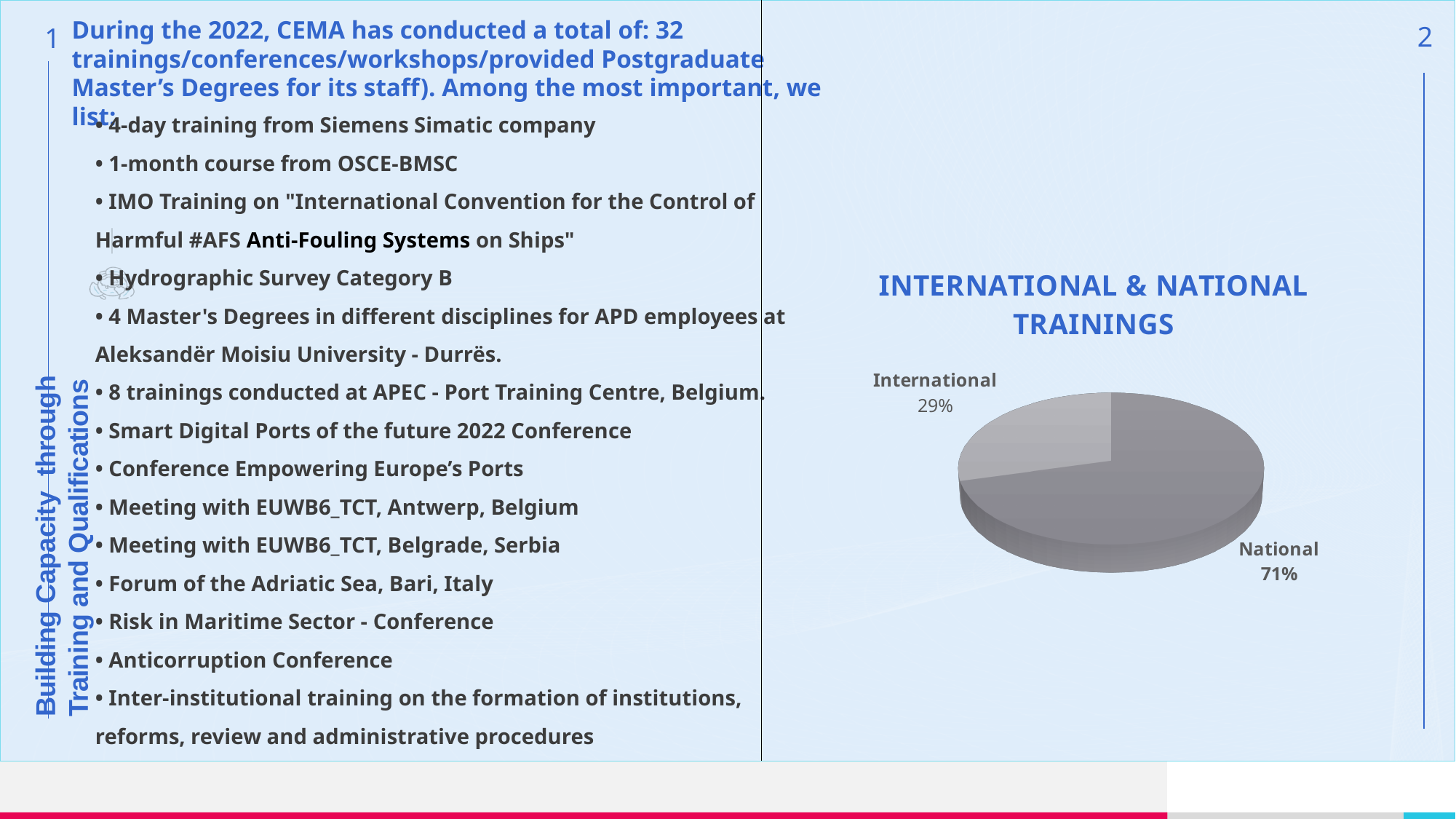
What is the title of the chart? INTERNATIONAL & NATIONAL TRAININGS What is the difference in percentage points between the National and International slices? 42 What do the two slices of the pie chart add up to? 100% Which slice of the pie chart is the smallest? International What share of the pie chart is National trainings? 71% Which slice of the pie chart is the largest? National What kind of chart is shown on the slide? Pie chart How many slices does the pie chart have? 2 Is the share for National greater or less than 50%? greater What share of the pie chart is International trainings? 29% Which is larger, the International slice or the National slice? National